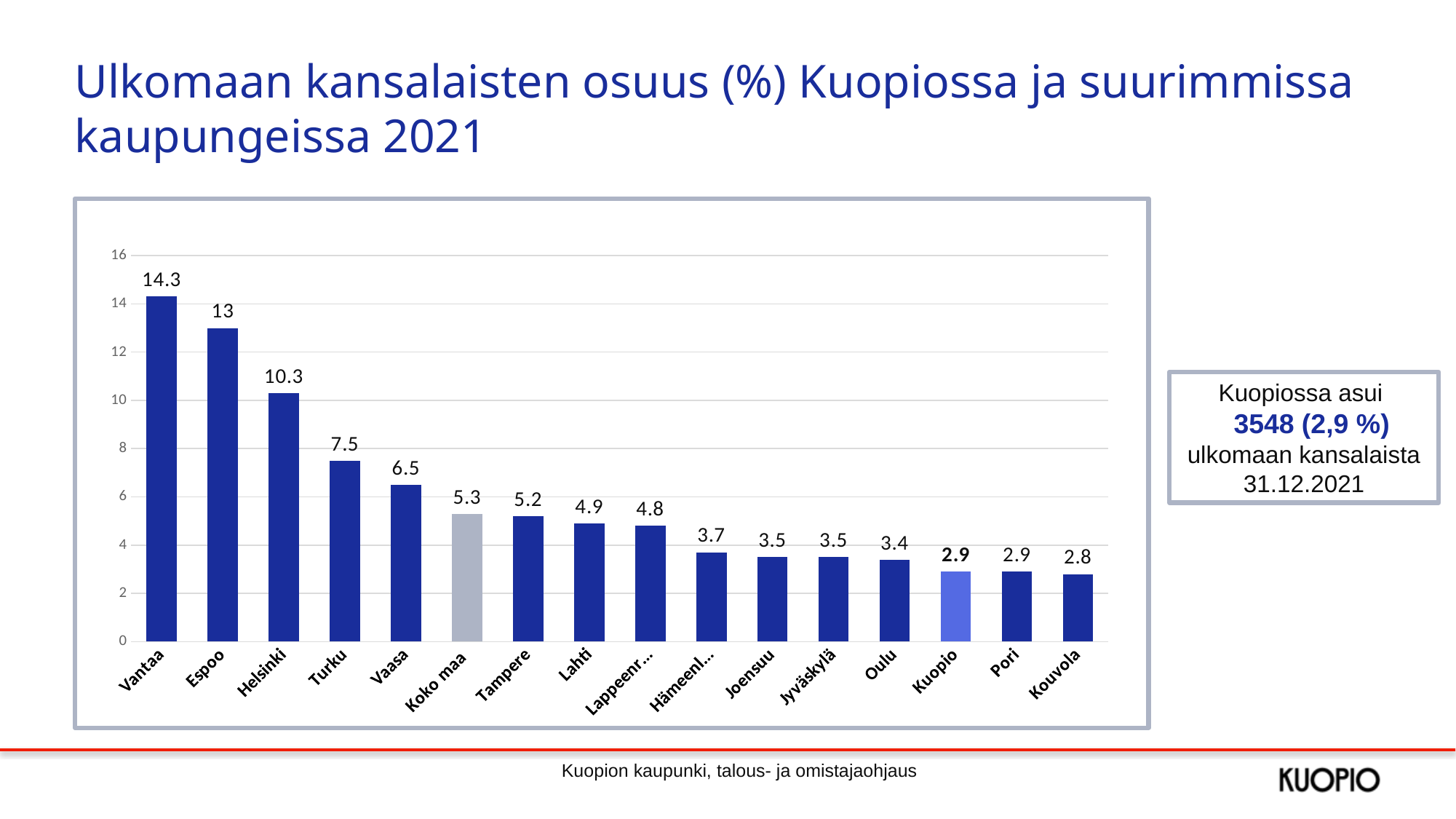
What is the value for Kuopio? 2.9 How many categories are shown in the chart? 16 Which is larger, the value for Tampere or the value for Vaasa? Vaasa What is the value for Helsinki? 10.3 What is the value for Koko maa? 5.3 What is the difference between the values for Vantaa and Espoo? 1.3 What is the value for Vantaa? 14.3 Which category has the lowest value? Kouvola What is the difference between the values for Turku and Kuopio? 4.6 Which category has the highest value? Vantaa Which bar is shown in grey rather than dark blue? Koko maa What type of chart is shown on the slide? bar chart